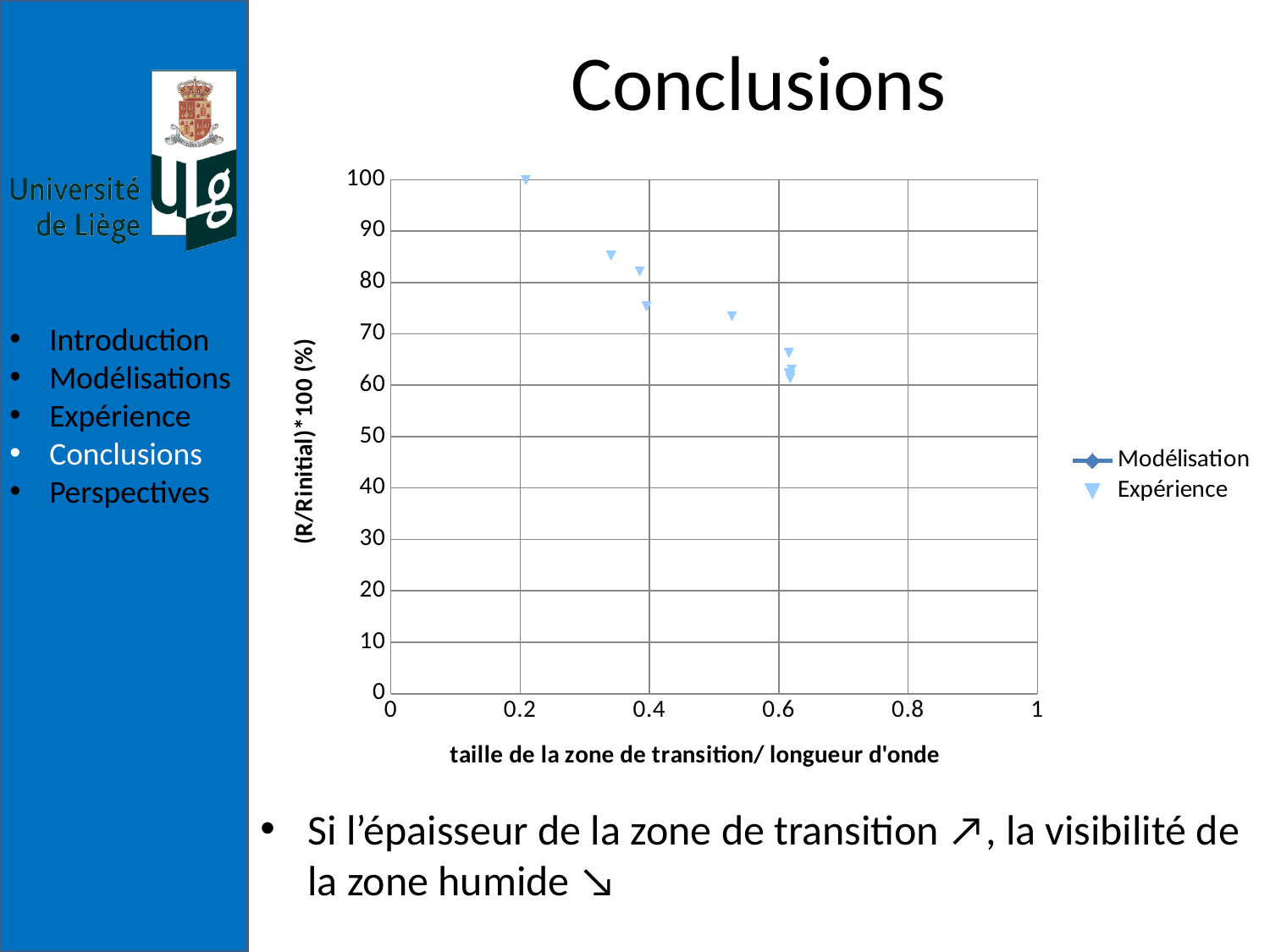
What is the title of the x axis? taille de la zone de transition/ longueur d'onde Do the Expérience values rise or fall as the x-axis value increases? fall Is the Expérience value at x ≈ 0.4 greater or less than 80? less Is the Expérience value at x ≈ 0.34 greater or less than 80? greater What kind of chart is shown on the slide? scatter chart Is the Expérience value at x ≈ 0.53 greater or less than 70? greater What are the two series named in the legend? Modélisation and Expérience Which has the larger value: the Expérience point at x ≈ 0.21 or the one at x ≈ 0.53? the point at x ≈ 0.21 What is the highest value reached by an Expérience point? 100 How many series does the legend list? 2 What is the maximum value shown on the x axis? 1